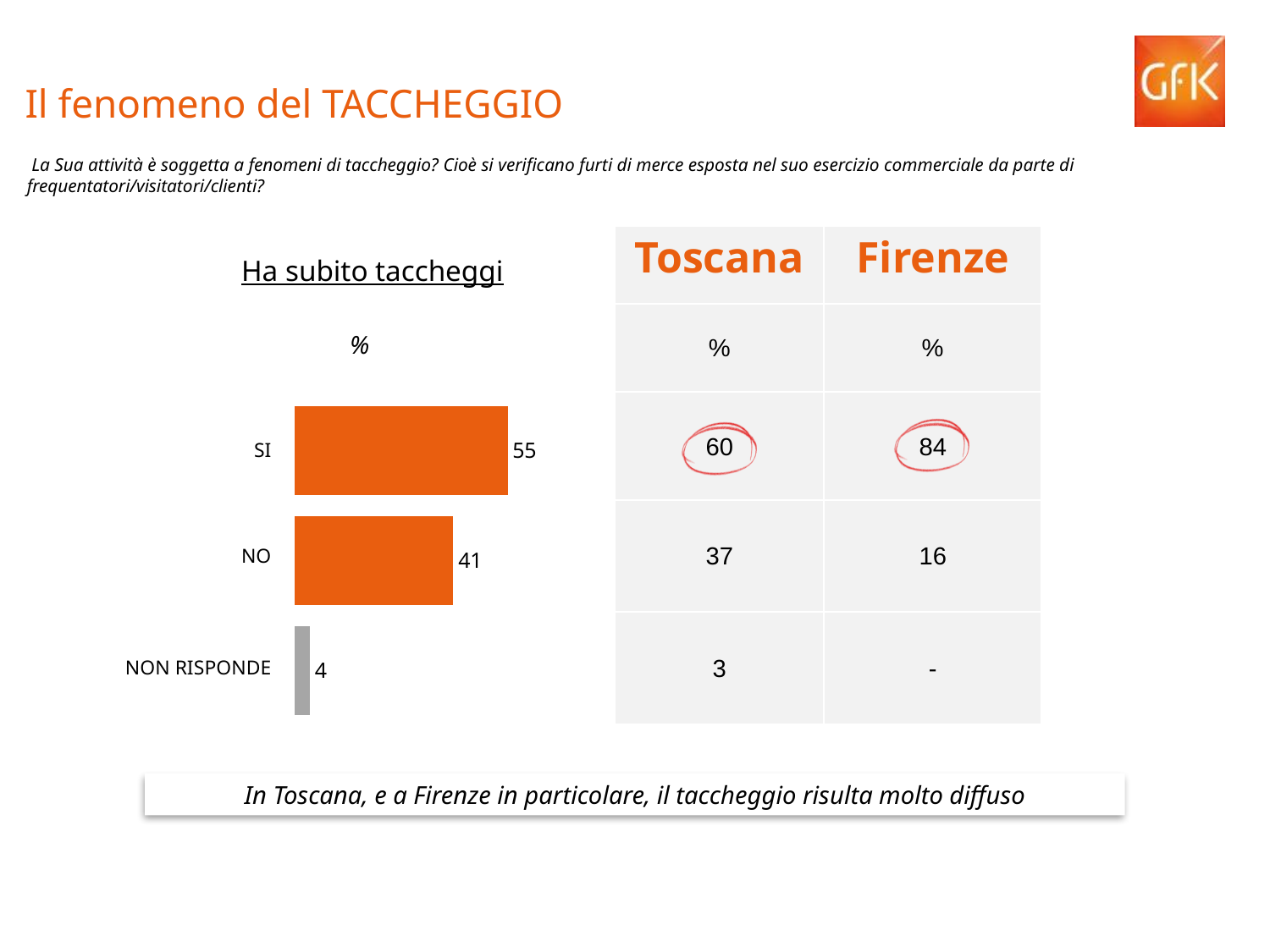
What is the difference between the SI and NO values in the 'Ha subito taccheggi' chart? 14 In the 'Ha subito taccheggi' chart, which bar is coloured grey rather than orange? NON RISPONDE What is the difference between the SI and NON RISPONDE values in the 'Ha subito taccheggi' chart? 51 What is the value for SI in the 'Ha subito taccheggi' chart? 55 What is the value for NO in the 'Ha subito taccheggi' chart? 41 What is the title of the bar chart on the slide? Ha subito taccheggi What kind of chart is the 'Ha subito taccheggi' chart? bar chart How many categories are shown in the 'Ha subito taccheggi' chart? 3 In the 'Ha subito taccheggi' chart, which is larger, the value for NO or the value for NON RISPONDE? NO What is the value for NON RISPONDE in the 'Ha subito taccheggi' chart? 4 Which category has the highest value in the 'Ha subito taccheggi' chart? SI Which category has the lowest value in the 'Ha subito taccheggi' chart? NON RISPONDE